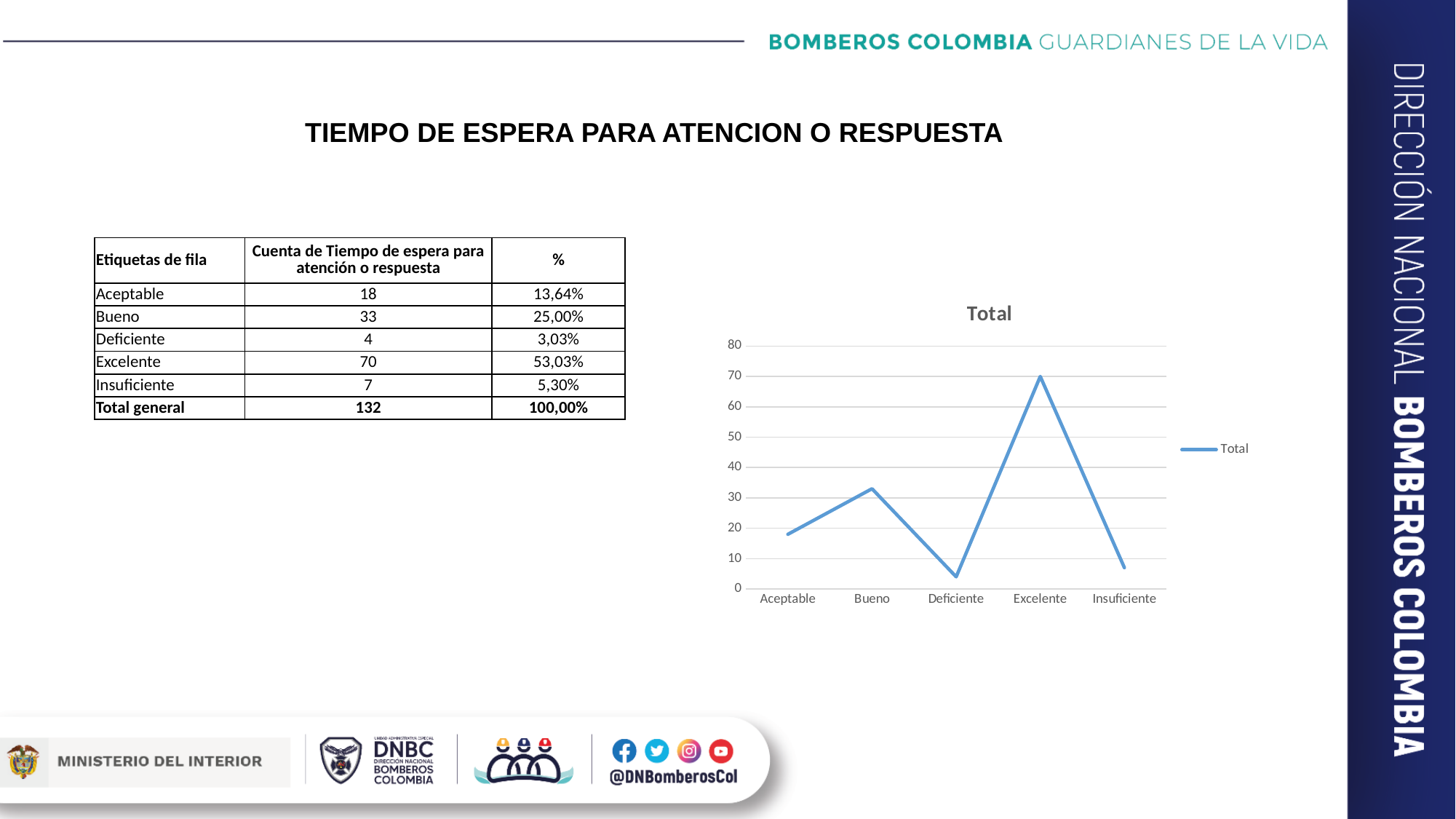
Is the value for Aceptable greater or less than 20? less What is the value for Bueno in the chart? 33 How many series does the chart legend list? 1 Is the value for Insuficiente greater or less than 10? less Which category has the highest value in the chart? Excelente What is the title of the chart? Total What is the difference between the values for Excelente and Bueno? 37 What kind of chart is shown on the slide? line chart Which is larger in the chart, the value for Bueno or the value for Aceptable? Bueno How many categories are plotted along the x axis of the chart? 5 Which category has the lowest value in the chart? Deficiente What is the value for Excelente in the chart? 70